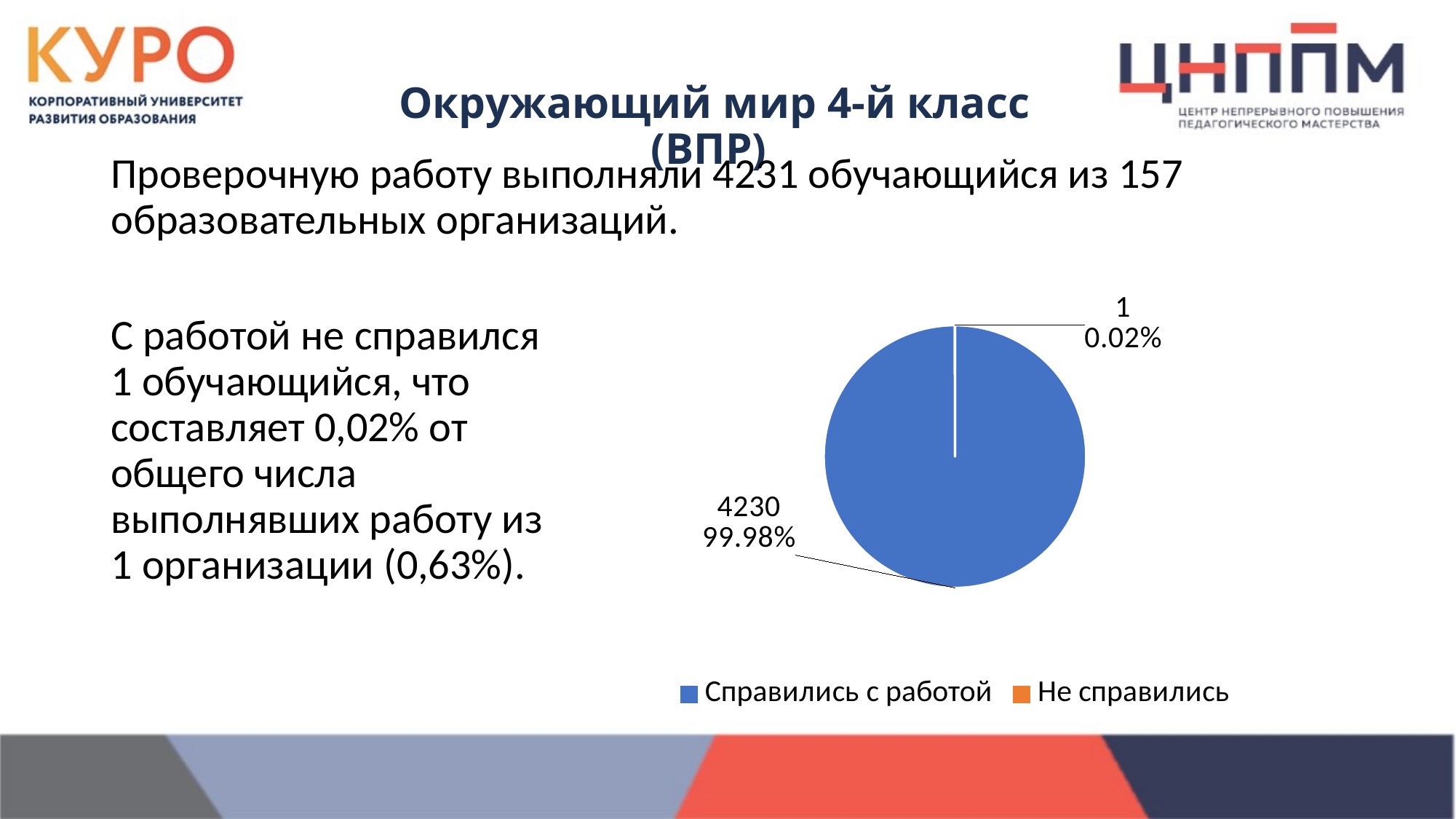
Which slice of the pie chart is the largest? Справились с работой What kind of chart is shown on the slide? pie chart Which slice of the pie chart is the smallest? Не справились What is the difference between the values for "Справились с работой" and "Не справились"? 4229 What is the value for "Не справились" in the pie chart? 1 How many entries does the legend of the pie chart list? 2 How many slices does the pie chart have? 2 What share of the pie does "Не справились" represent? 0.02% Which is larger: the value for "Справились с работой" or for "Не справились"? Справились с работой What colour is the "Справились с работой" slice in the pie chart? blue What is the value for "Справились с работой" in the pie chart? 4230 What share of the pie does "Справились с работой" represent? 99.98%